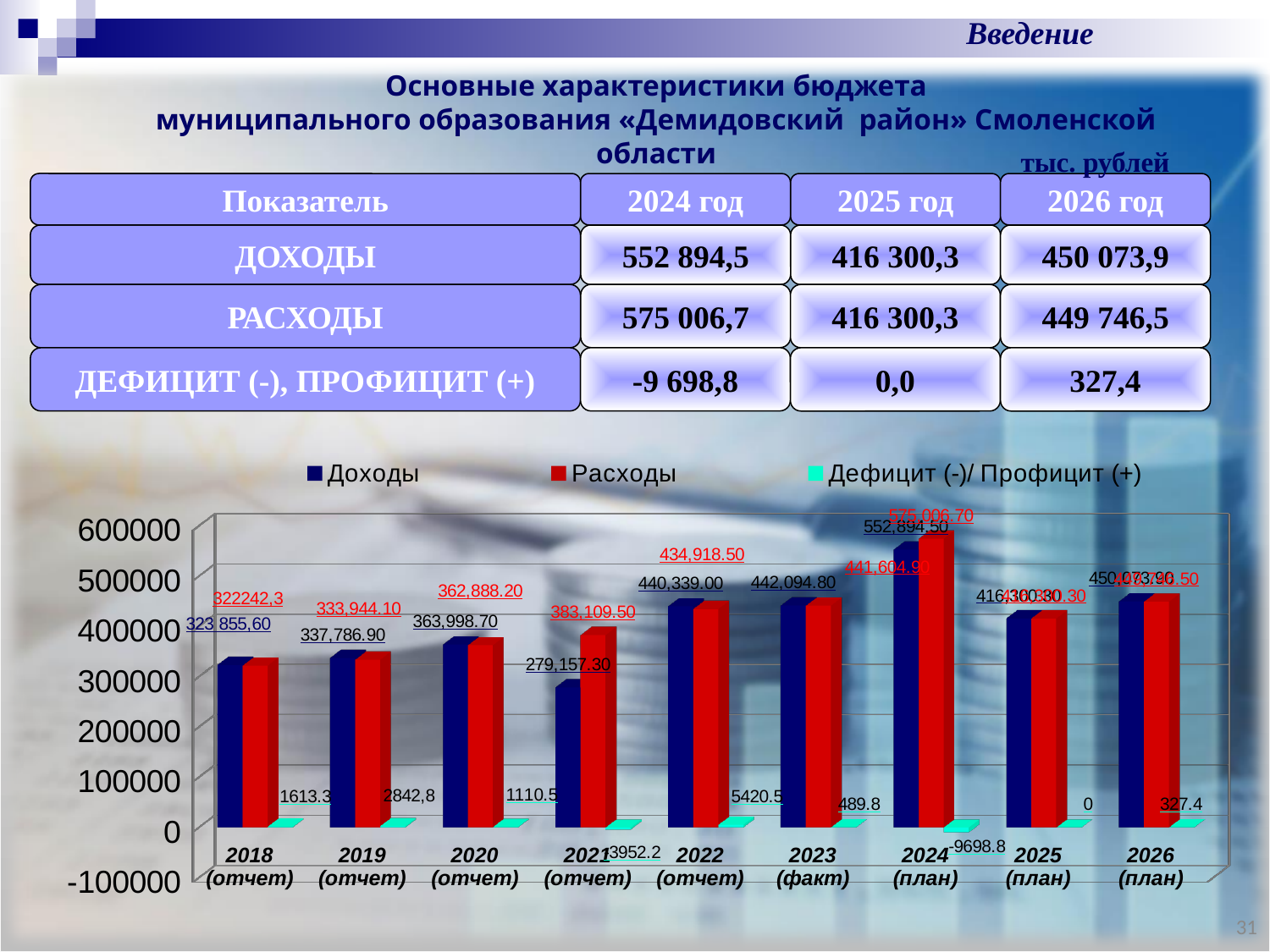
What is the value of Доходы for 2022 (отчет) in the chart? 440,339.00 What is the value of Дефицит (-)/ Профицит (+) for 2024 (план) in the chart? -9698.8 How many year categories are shown along the x axis of the chart? 9 What kind of chart is shown on the slide? Bar chart In the chart, which is larger for 2021 (отчет): Доходы or Расходы? Расходы Which colour represents Расходы in the chart legend? Red What is the difference between Расходы and Доходы for 2024 (план) in the chart? 22,112.20 Is the Доходы value for 2025 (план) greater or less than 500000? less In which year is Доходы lowest in the chart? 2021 (отчет) What is the value of Расходы for 2021 (отчет) in the chart? 383,109.50 In which year is Расходы highest in the chart? 2024 (план) How many series does the chart legend list? 3